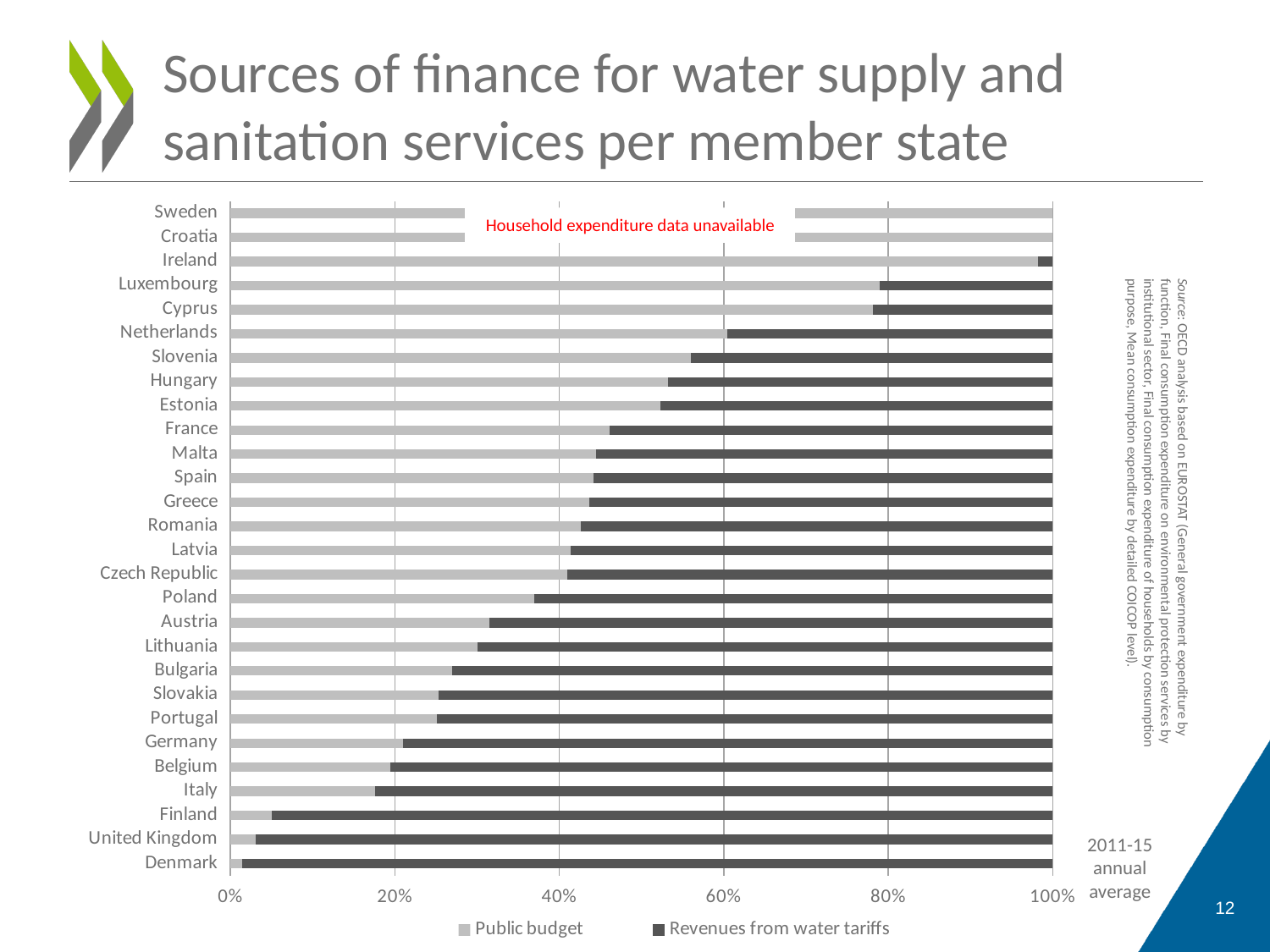
Is the public budget share for Italy greater or less than 20%? less Is the public budget share for Austria greater or less than 20%? greater Which series is shown in dark grey in the legend? Revenues from water tariffs How many member states are listed on the vertical axis of the chart? 28 Which has a larger public budget share, France or Poland? France Is the public budget share for Poland greater or less than 40%? less Which member state has the largest public budget share among those with household expenditure data? Ireland What kind of chart is shown on the slide? Stacked bar chart How many series does the legend list? 2 What period do the values in the chart represent, according to the note beside the chart? 2011-15 annual average Which member state has the smallest public budget share? Denmark